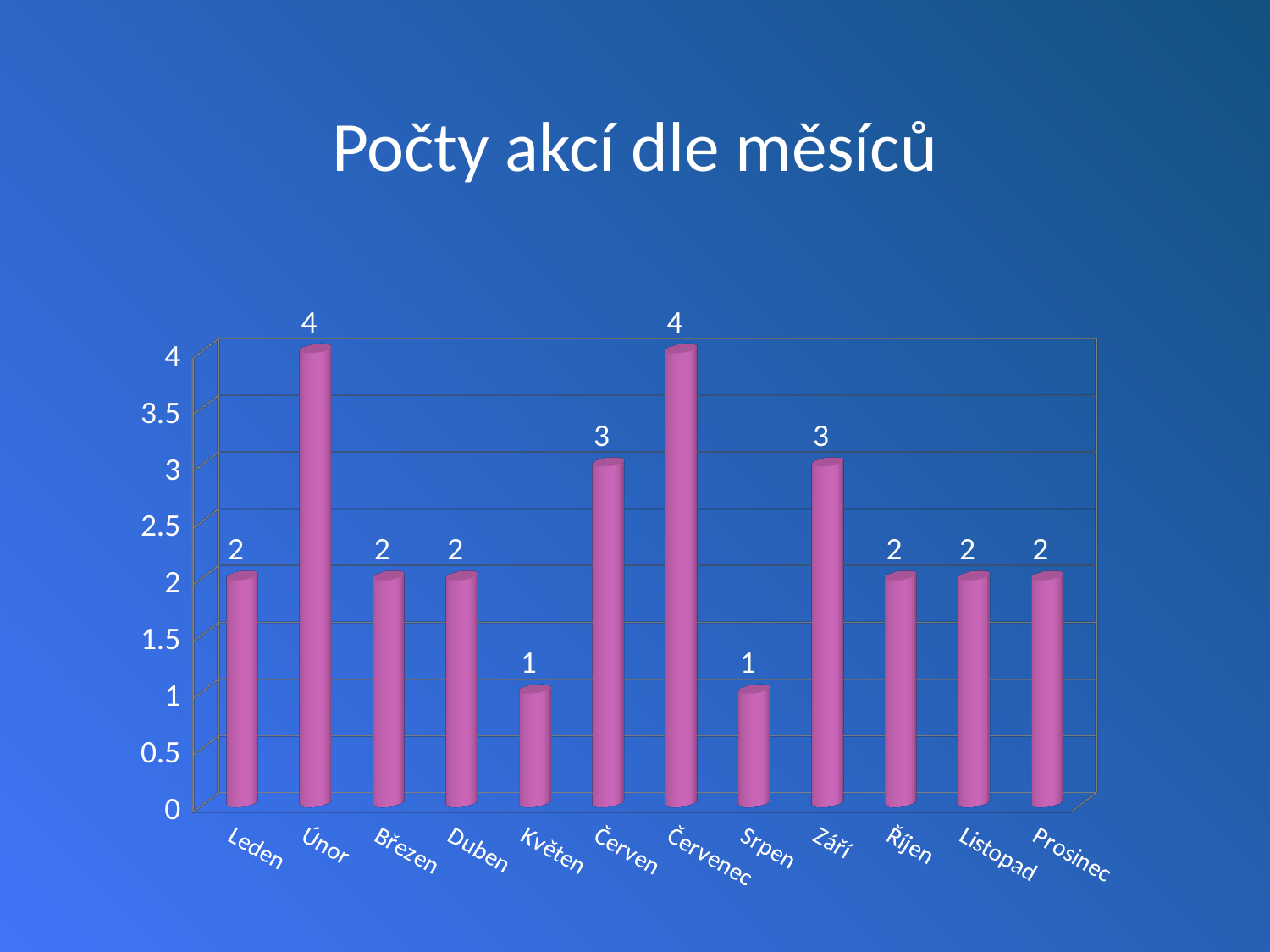
What is the value for Květen? 1 What is the title of the chart? Počty akcí dle měsíců How many months are shown on the x axis? 12 Which is larger, the value for Červen or the value for Duben? Červen Which months have the lowest value? Květen and Srpen What is the difference between the values for Červenec and Srpen? 3 What is the value for Září? 3 What kind of chart is shown on the slide? bar chart Is the value for Únor greater or less than 3? greater What is the value for Prosinec? 2 What is the value for Únor? 4 Which months have the highest value? Únor and Červenec